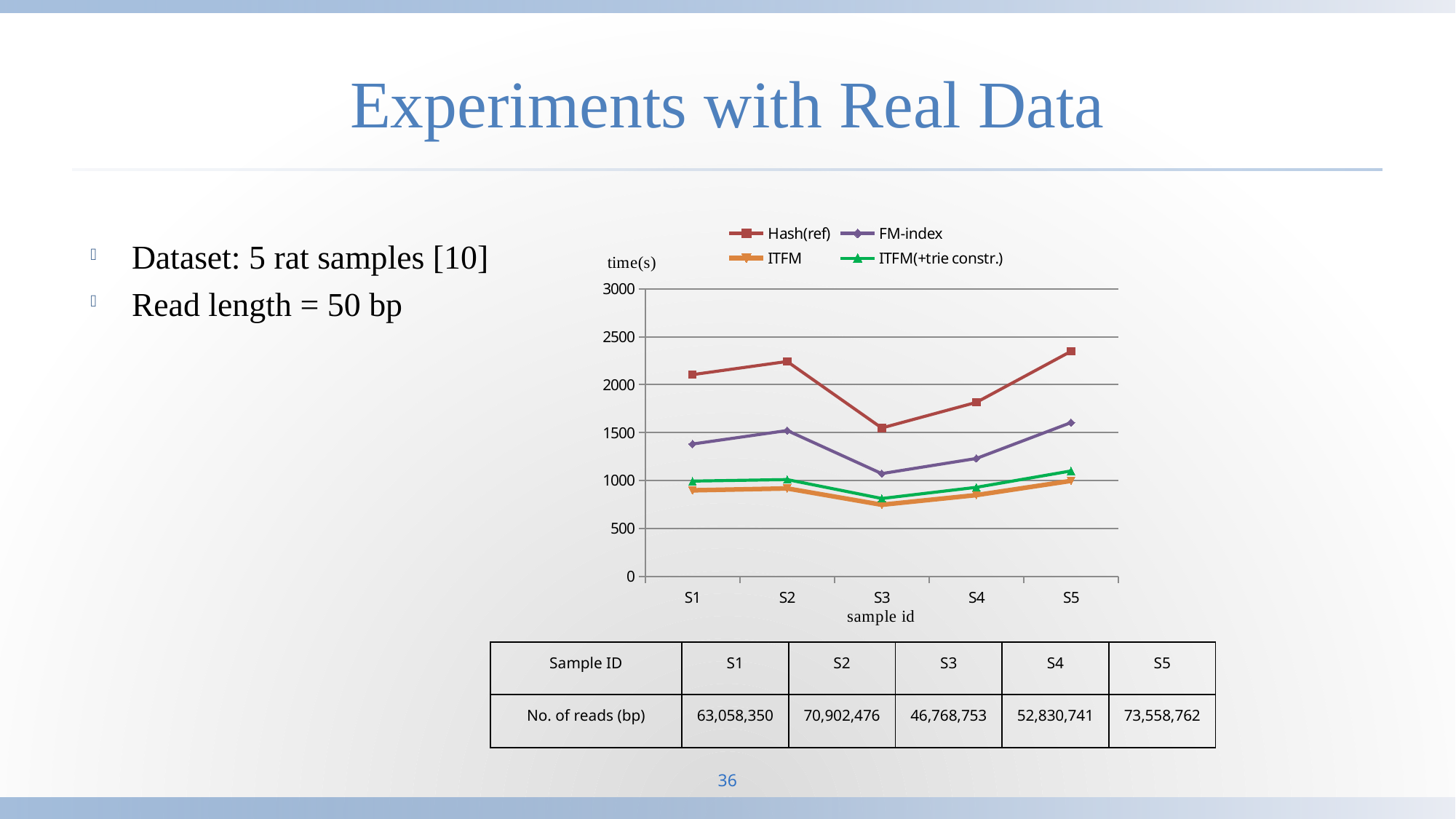
For the FM-index series, which sample id has the lowest time? S3 Is the FM-index value for S3 greater or less than 1500? less For the Hash(ref) series, which sample id has the highest time? S5 At S2, which series has the larger value, Hash(ref) or FM-index? Hash(ref) What kind of chart is shown on the slide? line chart Is the ITFM value for S3 greater or less than 1000? less Does the Hash(ref) series rise or fall from S3 to S5? rise Is the Hash(ref) value for S1 greater or less than 2000? greater How many sample ids are plotted along the x axis? 5 For the Hash(ref) series, which sample id has the lowest time? S3 How many series does the chart's legend list? 4 What is the label on the chart's x axis? sample id